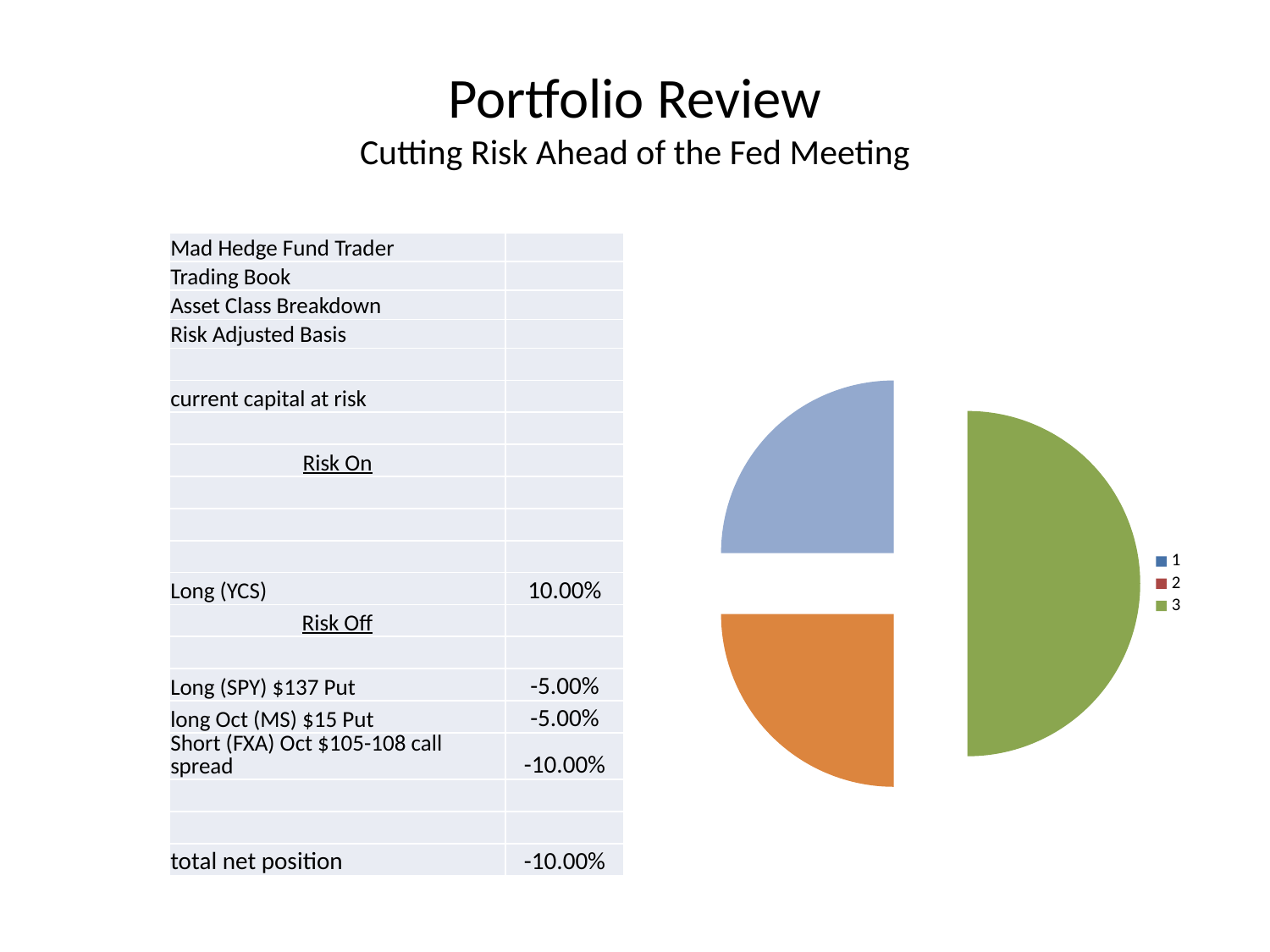
How many entries does the pie chart's legend list? 3 Which legend category has the largest slice in the pie chart? 3 What kind of chart is shown on the right side of the slide? pie chart What colour is the largest slice of the pie chart? green What are the entries listed in the pie chart's legend? 1, 2, 3 In the pie chart, which slice is larger: category 2 or category 3? 3 How many slices does the pie chart have? 3 In the pie chart, which slice is larger: category 3 or category 1? 3